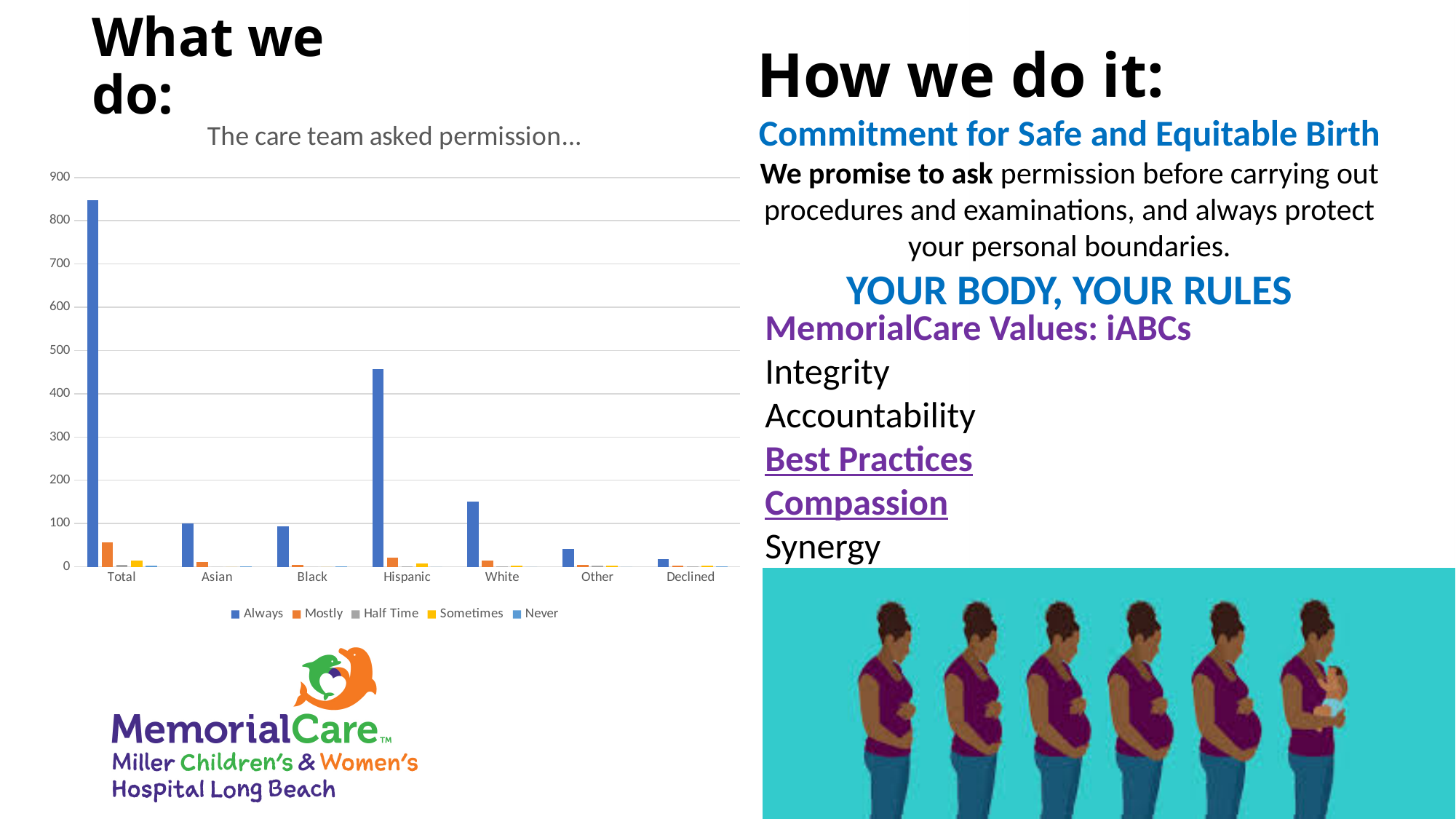
Which is larger, the Always value for Hispanic or the Always value for White? Hispanic Which category has the highest value for the Always series? Total What kind of chart is shown on the slide? bar chart Which series is shown in orange in the chart legend? Mostly How many categories are shown on the x axis of the chart? 7 How many series does the chart legend list? 5 Is the Always value for White greater or less than 100? greater Is the Always value for Total greater or less than 800? greater Is the Always value for Hispanic greater or less than 400? greater What is the title of the chart? The care team asked permission... Which category has the lowest value for the Always series? Declined